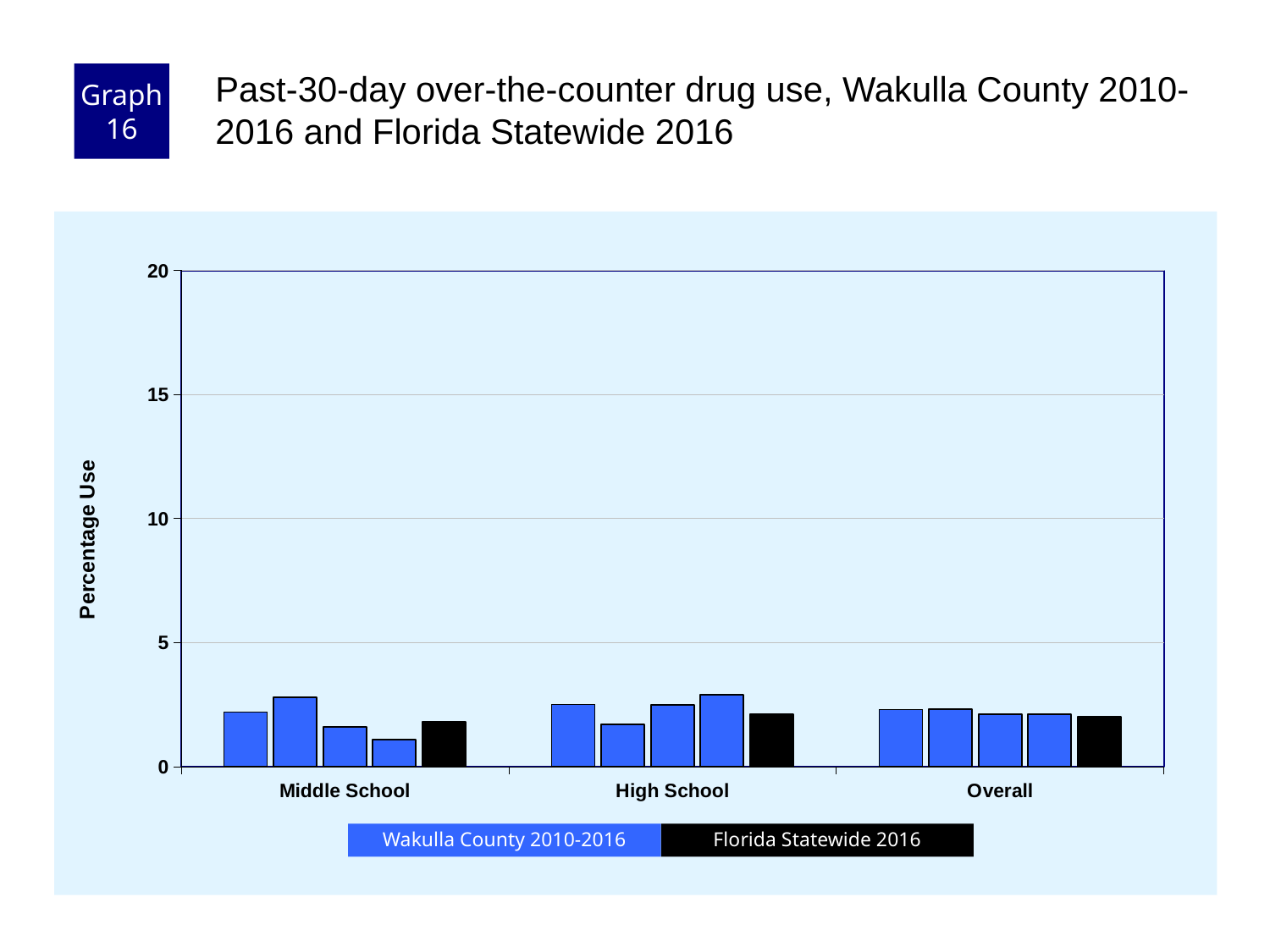
Is the Florida Statewide 2016 value for High School greater or less than 5? less Is the Florida Statewide 2016 value for Middle School greater or less than 5? less Are any of the Wakulla County 2010-2016 values for High School greater or less than 10? less What is the highest value shown on the y axis of the chart? 20 How many categories are shown on the x axis of the chart? 3 What is the title of the chart on the slide? Past-30-day over-the-counter drug use, Wakulla County 2010-2016 and Florida Statewide 2016 What type of chart is shown on the slide? bar chart How many series does the chart's legend list? 2 What is the label on the y axis of the chart? Percentage Use